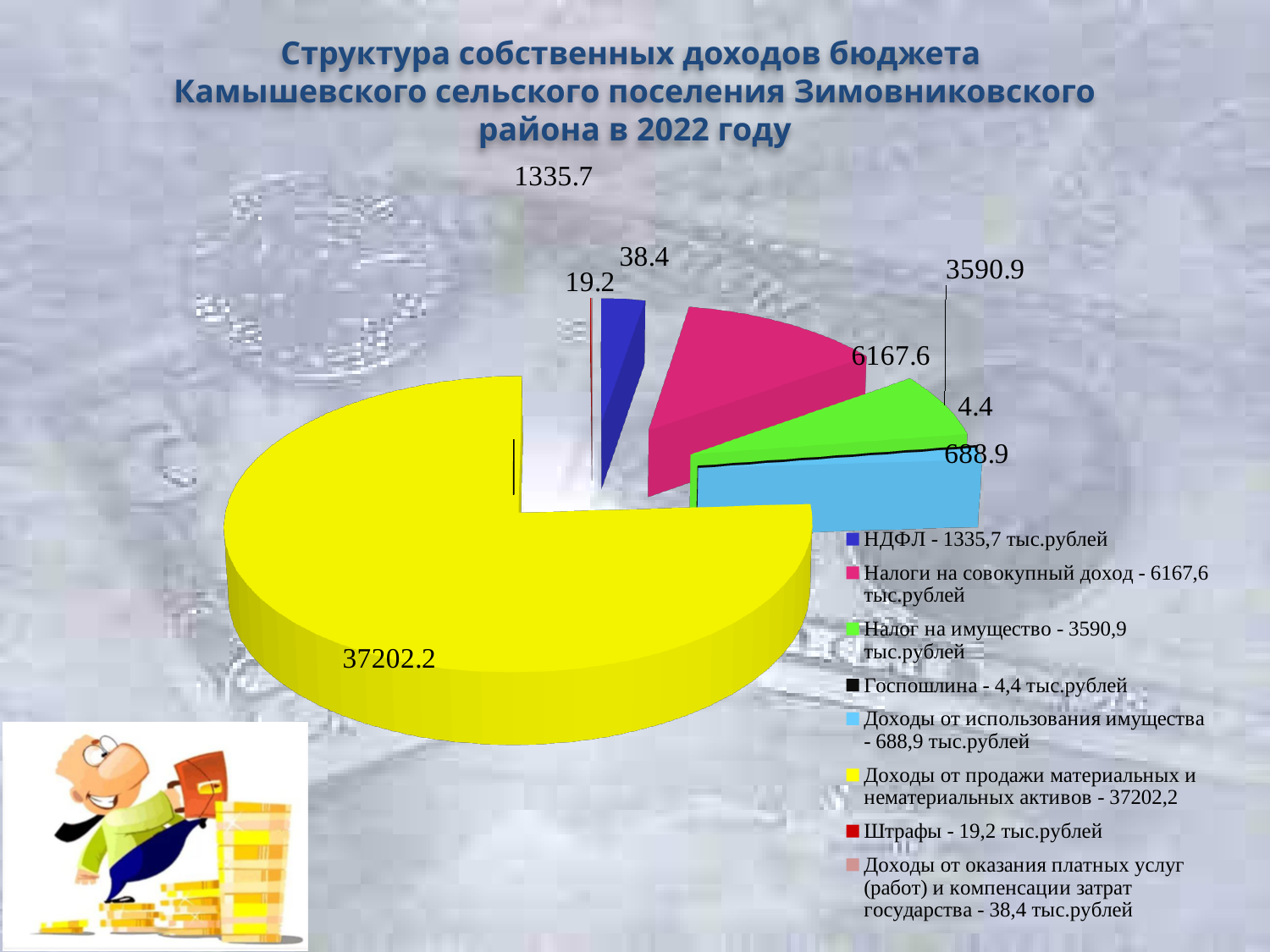
How many slices does the pie chart have? 8 Which is larger, НДФЛ or Доходы от использования имущества? НДФЛ What is the value for НДФЛ? 1335.7 What is the value for Налог на имущество? 3590.9 Which category has the smallest value? Госпошлина What is the value for Госпошлина? 4.4 What is the value for Штрафы? 19.2 What is the value for Налоги на совокупный доход? 6167.6 What type of chart is shown on the slide? pie chart What colour is the slice for Доходы от продажи материальных и нематериальных активов? yellow Which category has the largest slice of the pie? Доходы от продажи материальных и нематериальных активов What is the difference between Налоги на совокупный доход and Налог на имущество? 2576.7